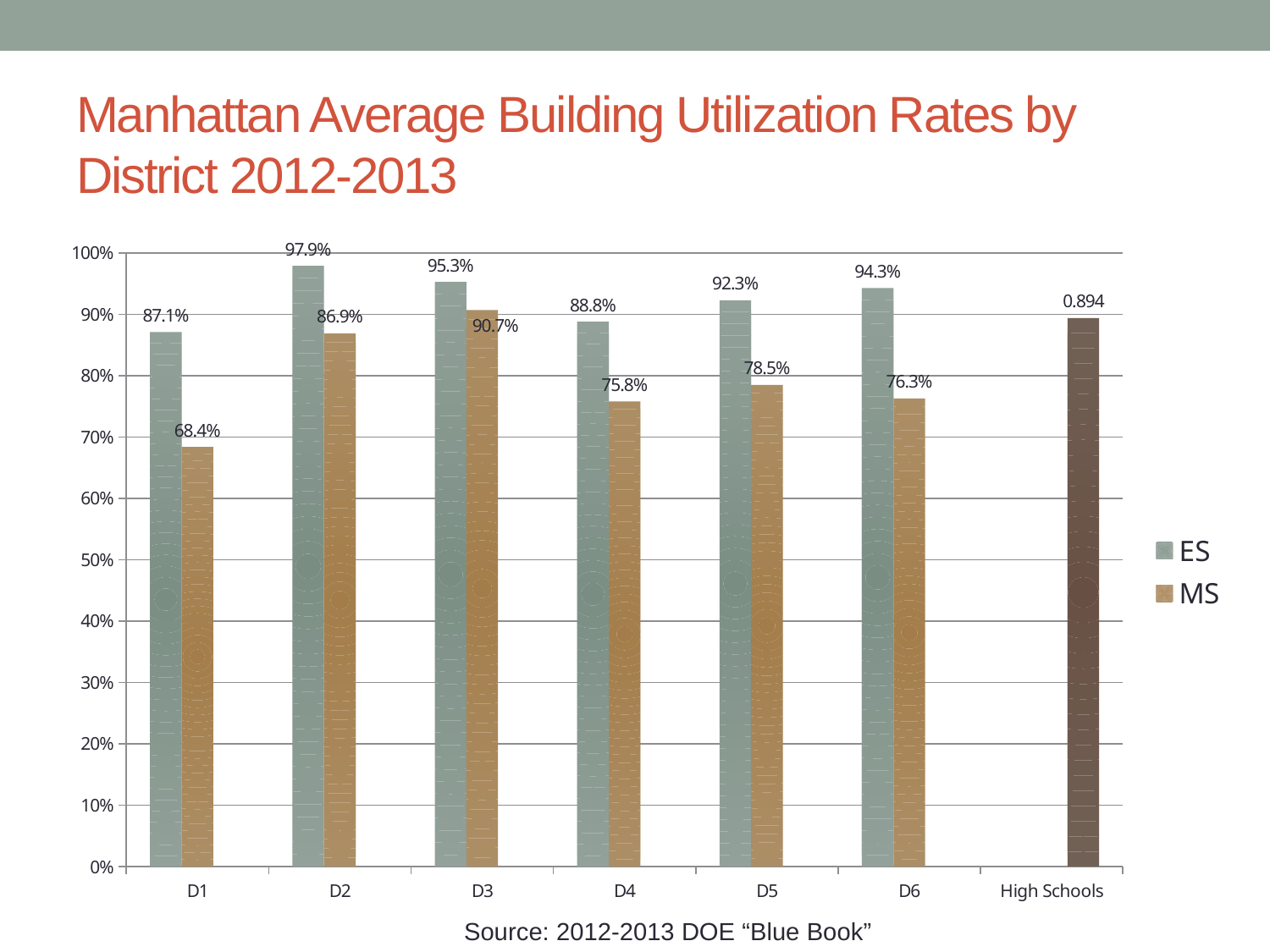
What kind of chart is shown on the slide? bar chart How many categories are shown on the x axis? 7 Which is larger, the MS value for D5 or the MS value for D6? D5 Which district has the highest ES value? D2 What is the difference between the ES and MS values for D1? 18.7% Which district has the lowest MS value? D1 Is the MS value for D4 greater or less than 80%? less How many series does the legend list? 2 What is the MS value for D1? 68.4% What value is labeled on the High Schools bar? 0.894 What is the MS value for D3? 90.7% What is the ES value for D2? 97.9%